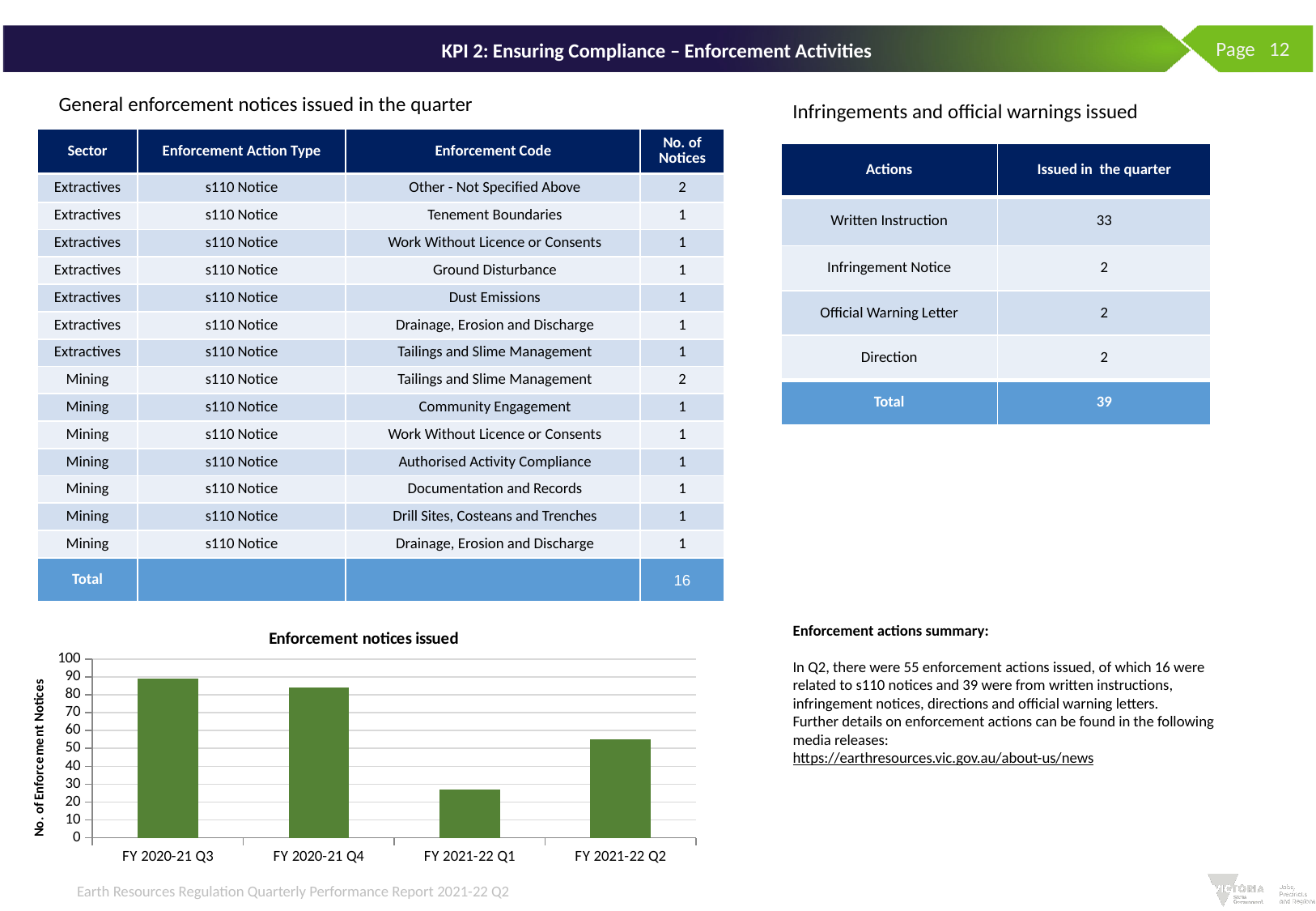
What is the title of the chart? Enforcement notices issued Is the value for FY 2021-22 Q1 greater or less than 30? less Which quarter has the lowest number of enforcement notices in the chart? FY 2021-22 Q1 Is the value for FY 2020-21 Q4 greater or less than 70? greater Is the value for FY 2020-21 Q3 greater or less than 80? greater How many quarters are plotted in the Enforcement notices issued chart? 4 What kind of chart is shown on the slide? bar chart What is the label on the vertical axis of the chart? No. of Enforcement Notices Which has more enforcement notices, FY 2021-22 Q1 or FY 2021-22 Q2? FY 2021-22 Q2 Do the values rise or fall from FY 2020-21 Q3 to FY 2021-22 Q1? fall Which quarter has the highest number of enforcement notices in the chart? FY 2020-21 Q3